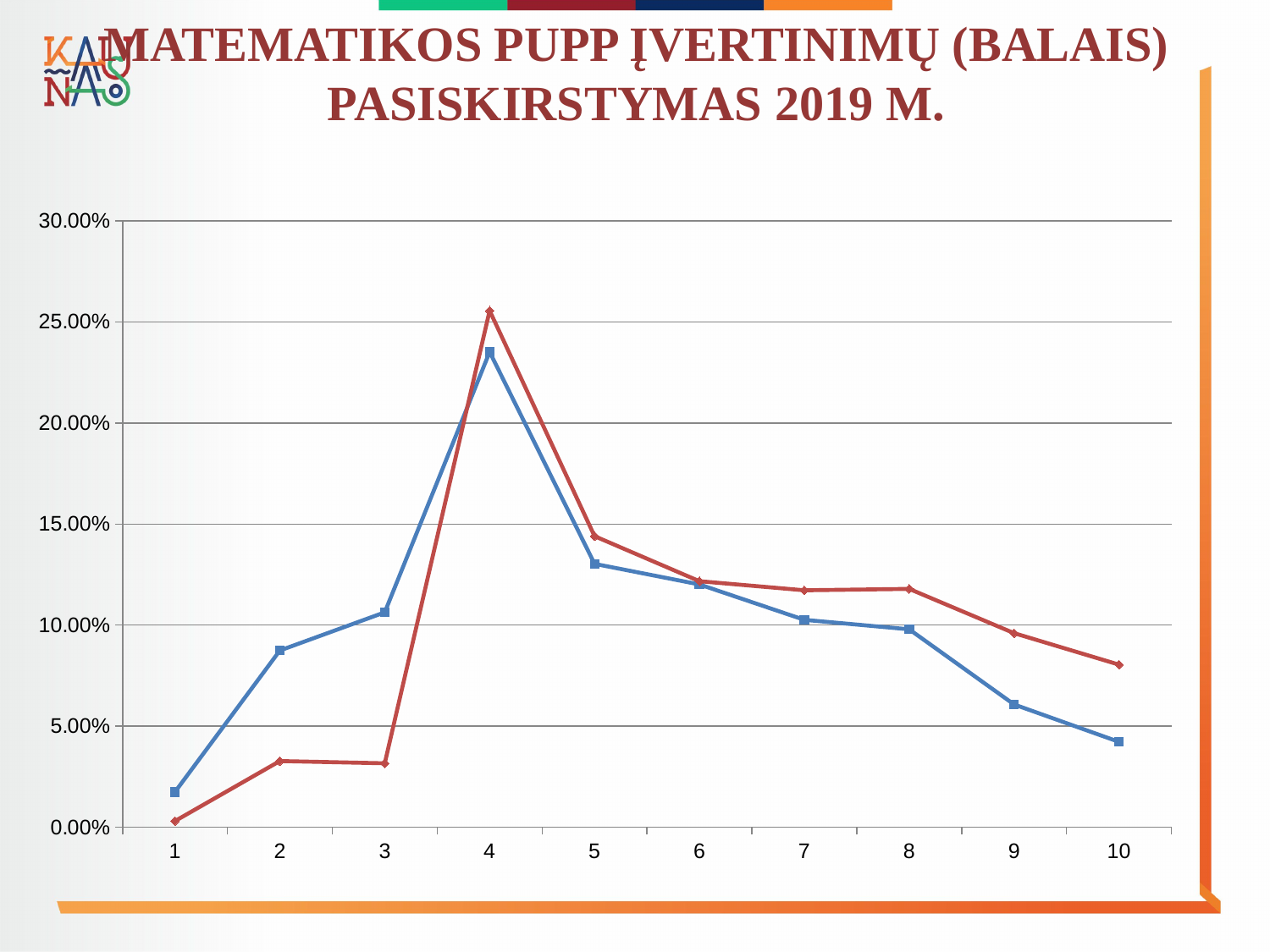
Is the value of the blue line at category 10 greater or less than 5.00%? less At which x-axis category does the blue line reach its highest value? 4 Is the value of the red line at category 3 greater or less than 5.00%? less At which x-axis category does the red line reach its highest value? 4 Is the value of the red line at category 4 greater or less than 25.00%? greater At category 9, which line has the higher value, the blue line or the red line? red line At which x-axis category does the red line have its lowest value? 1 What kind of chart is shown on the slide? line chart How many categories are shown on the x axis of the chart? 10 At category 2, which line has the higher value, the blue line or the red line? blue line At which x-axis category does the blue line have its lowest value? 1 Do the values of the blue line rise or fall from category 4 to category 10? fall